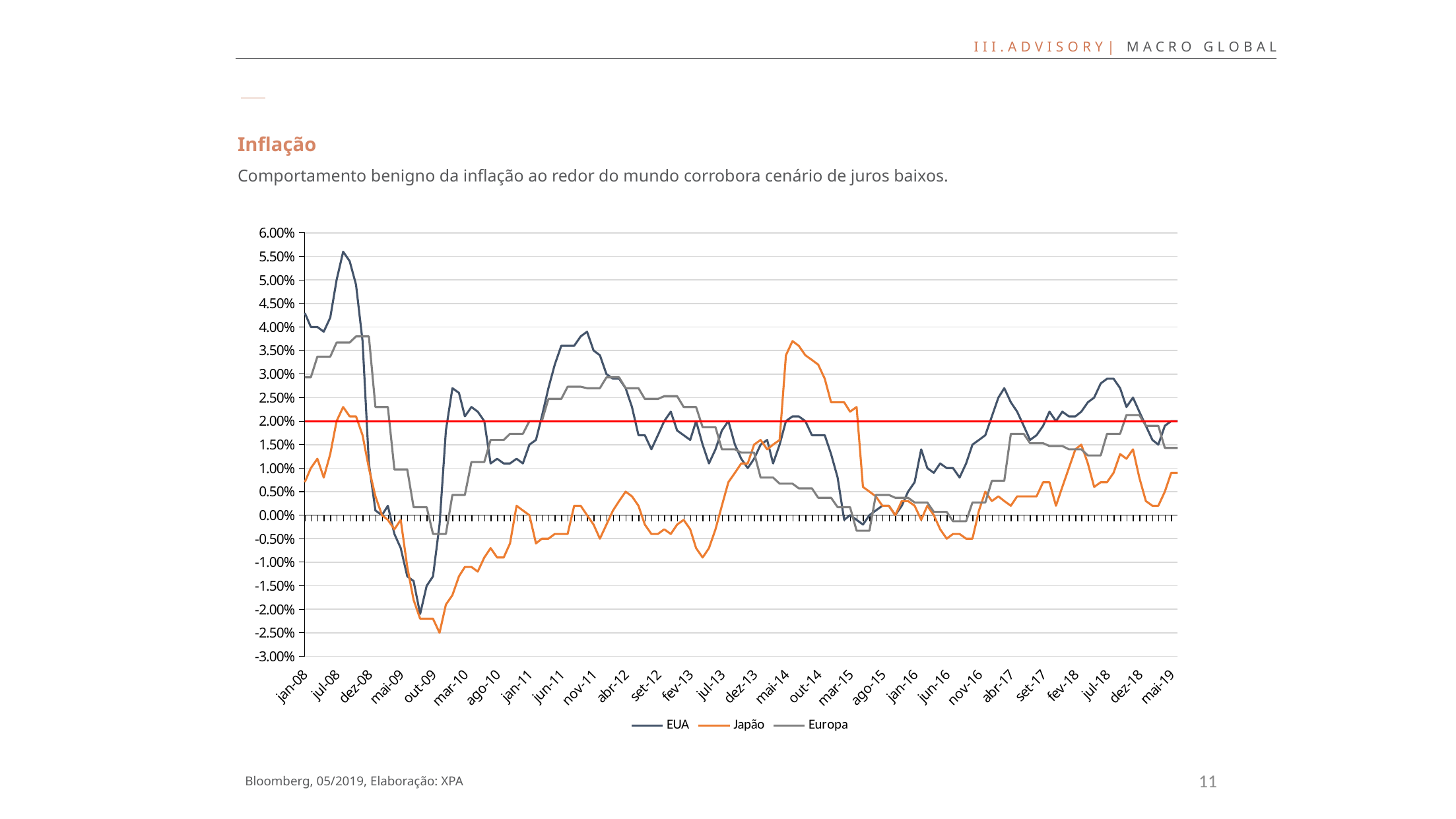
Which series reaches the lowest value anywhere on the chart? Japão How many series does the chart legend list? 3 At jan-08, which series has the higher value, EUA or Europa? EUA What kind of chart is shown on the slide? line chart Is the peak value of the EUA series around jul-08 greater or less than 5.00%? greater At what level is the horizontal red reference line drawn? 2.00% Is the value for Europa at mai-19 greater or less than 2.00%? less Is the value for Japão at fev-13 greater or less than 0.00%? less Does the EUA series rise or fall between jul-08 and out-09? fall At out-14, which series has the higher value, Japão or EUA? Japão Which series reaches the highest value anywhere on the chart? EUA